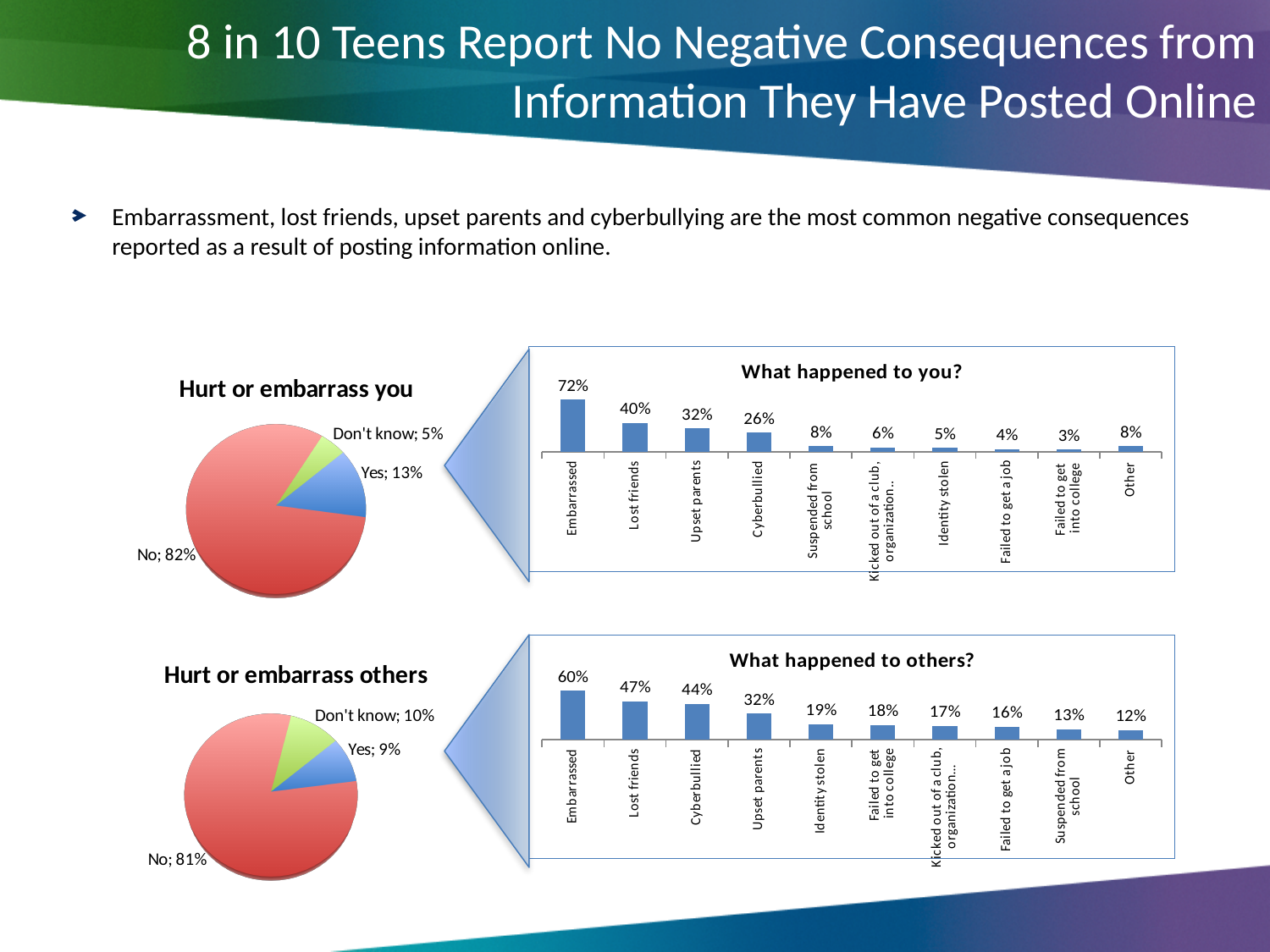
In the 'Hurt or embarrass you' pie chart, what share of respondents answered No? 82% What kind of chart is 'Hurt or embarrass you'? Pie chart In the 'What happened to you?' chart, what is the value for Cyberbullied? 26% What kind of chart is 'What happened to you?'? Bar chart In the 'What happened to others?' chart, which category has the lowest value? Other In the 'What happened to others?' chart, what is the value for Identity stolen? 19% How many categories are shown in the 'What happened to others?' chart? 10 Which is larger in the 'What happened to you?' chart: Upset parents or Lost friends? Lost friends In the 'What happened to you?' chart, which category has the highest value? Embarrassed In the 'Hurt or embarrass others' pie chart, what share of respondents answered Don't know? 10% In the 'What happened to you?' chart, which category has the lowest value? Failed to get into college In the 'What happened to others?' chart, what is the difference between Embarrassed and Lost friends? 13%